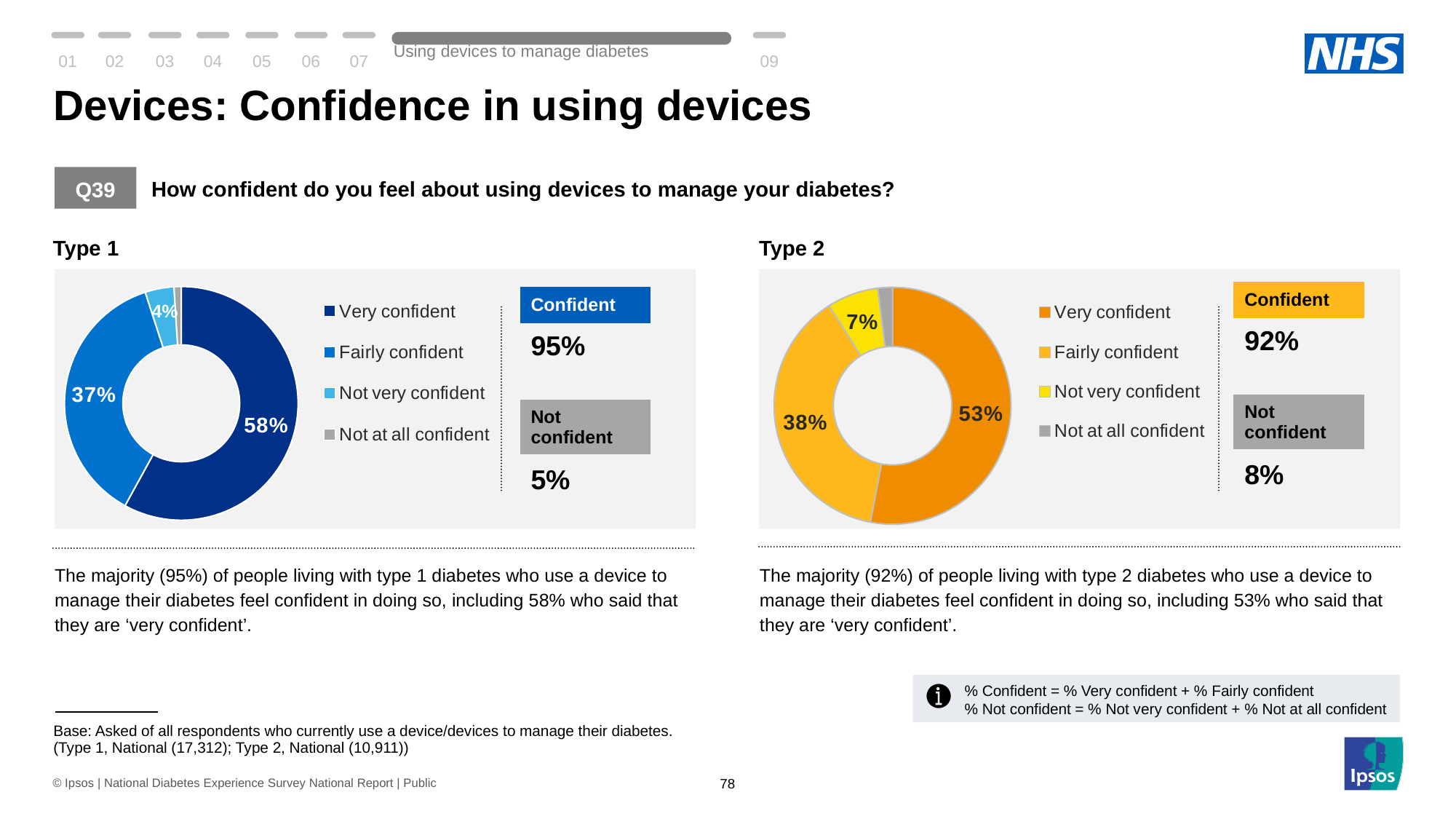
How many categories does the Type 1 chart show? 4 What colour represents the 'Not at all confident' category in the Type 2 chart? Grey Which is larger: the very confident share in the Type 1 chart or the very confident share in the Type 2 chart? Type 1 In the Type 1 chart, which category has the largest slice? Very confident In the Type 2 chart, which category has the smallest slice? Not at all confident How many entries does the legend of the Type 2 chart list? 4 In the Type 2 chart, what percentage of respondents said they are fairly confident? 38% In the Type 1 chart, what percentage of respondents said they are very confident? 58% In the Type 2 chart, what percentage of respondents said they are not very confident? 7% In the Type 1 chart, what is the difference between the very confident and fairly confident percentages? 21 percentage points What kind of chart is used for Type 1? Pie (donut) chart In the Type 2 chart, what is the difference between the very confident and fairly confident percentages? 15 percentage points